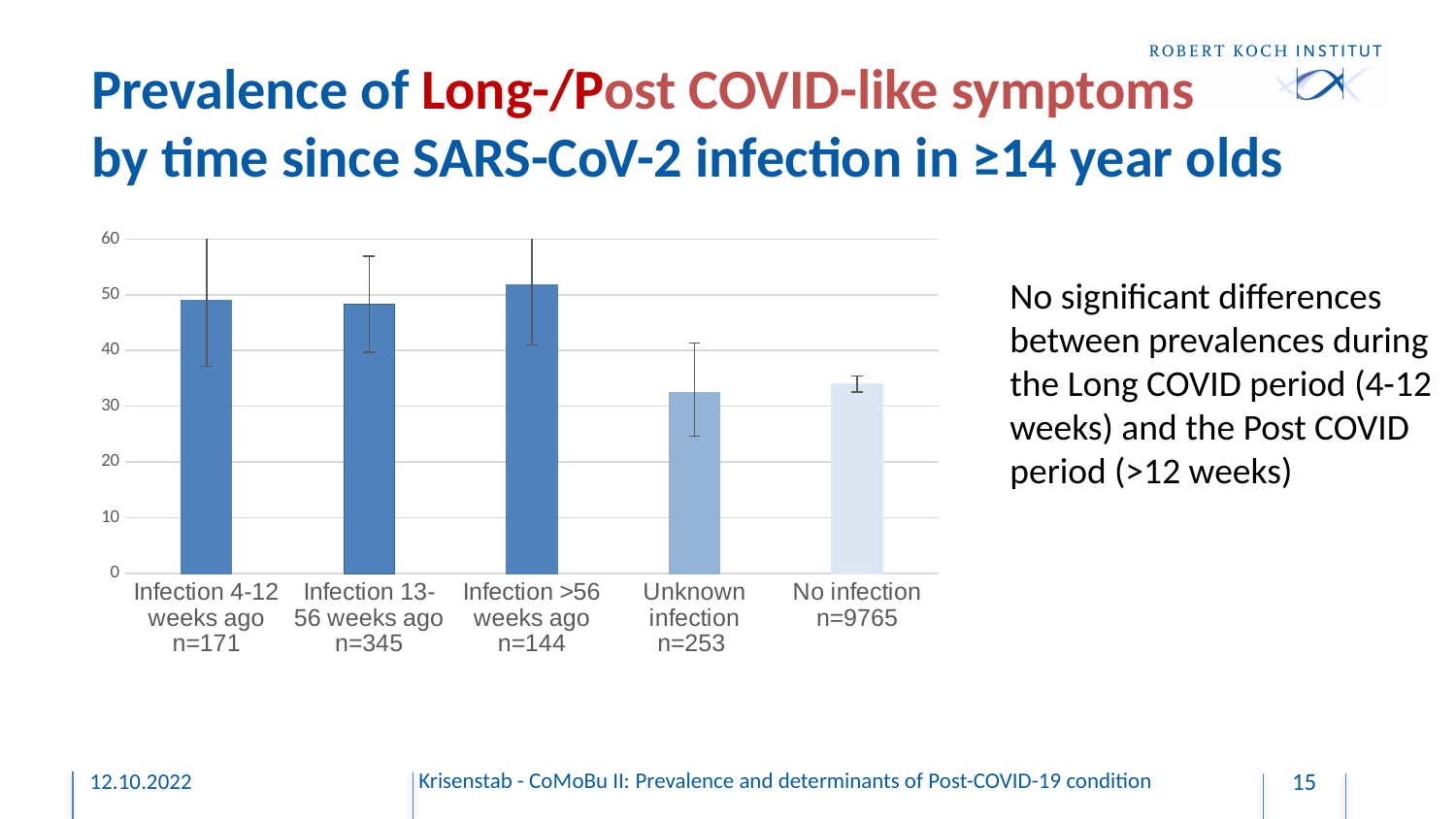
Is the value for 'Infection 13-56 weeks ago' greater or less than 40? greater What is the highest value shown on the y axis of the chart? 60 What is the sample size (n) given for the 'No infection' category? n=9765 Is the value for 'Unknown infection' greater or less than 40? less Is the value for 'Infection 4-12 weeks ago' greater or less than 40? greater Which is larger, the value for 'Infection 4-12 weeks ago' or the value for 'Unknown infection'? Infection 4-12 weeks ago What kind of chart is shown on the slide? bar chart How many categories are shown on the x axis of the chart? 5 What is the sample size (n) given for the 'Infection 13-56 weeks ago' category? n=345 Which is larger, the value for 'Infection >56 weeks ago' or the value for 'No infection'? Infection >56 weeks ago